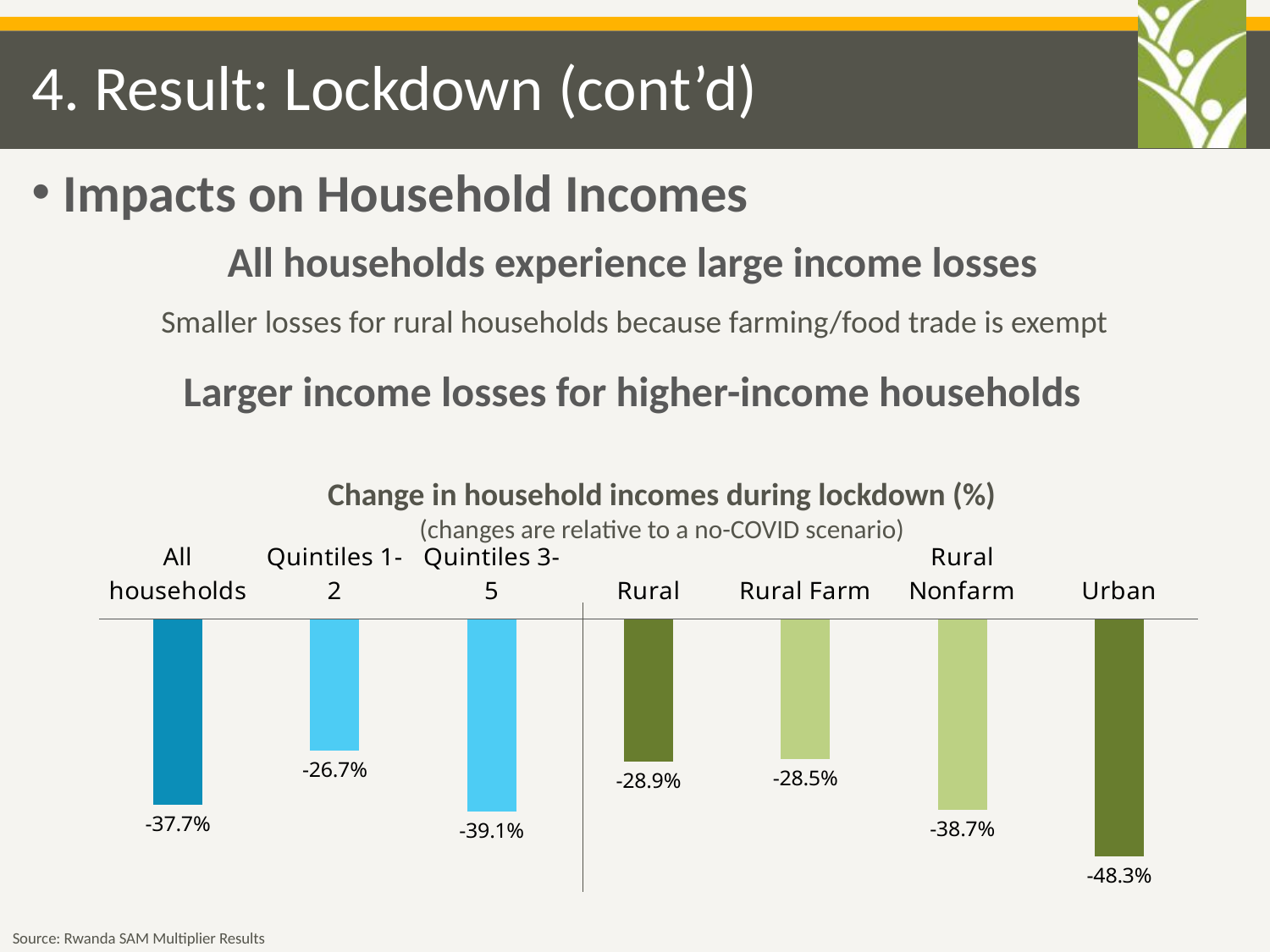
What is the change in household income for Urban households during lockdown? -48.3% What is the value shown for Rural Nonfarm households? -38.7% Which household group shows the smallest income loss? Quintiles 1-2 How many percentage points larger is the income loss for Urban households than for Quintiles 1-2? 21.6 Which household group shows the largest income loss? Urban How many percentage points larger is the income loss for All households than for Rural households? 8.8 What is the change in income for Quintiles 1-2? -26.7% What is the value shown for All households? -37.7% Which group has a larger income loss, Quintiles 3-5 or Rural? Quintiles 3-5 What is the value shown for Rural Farm households? -28.5% How many household categories are shown in the chart? 7 What type of chart is used to show the change in household incomes? Bar chart